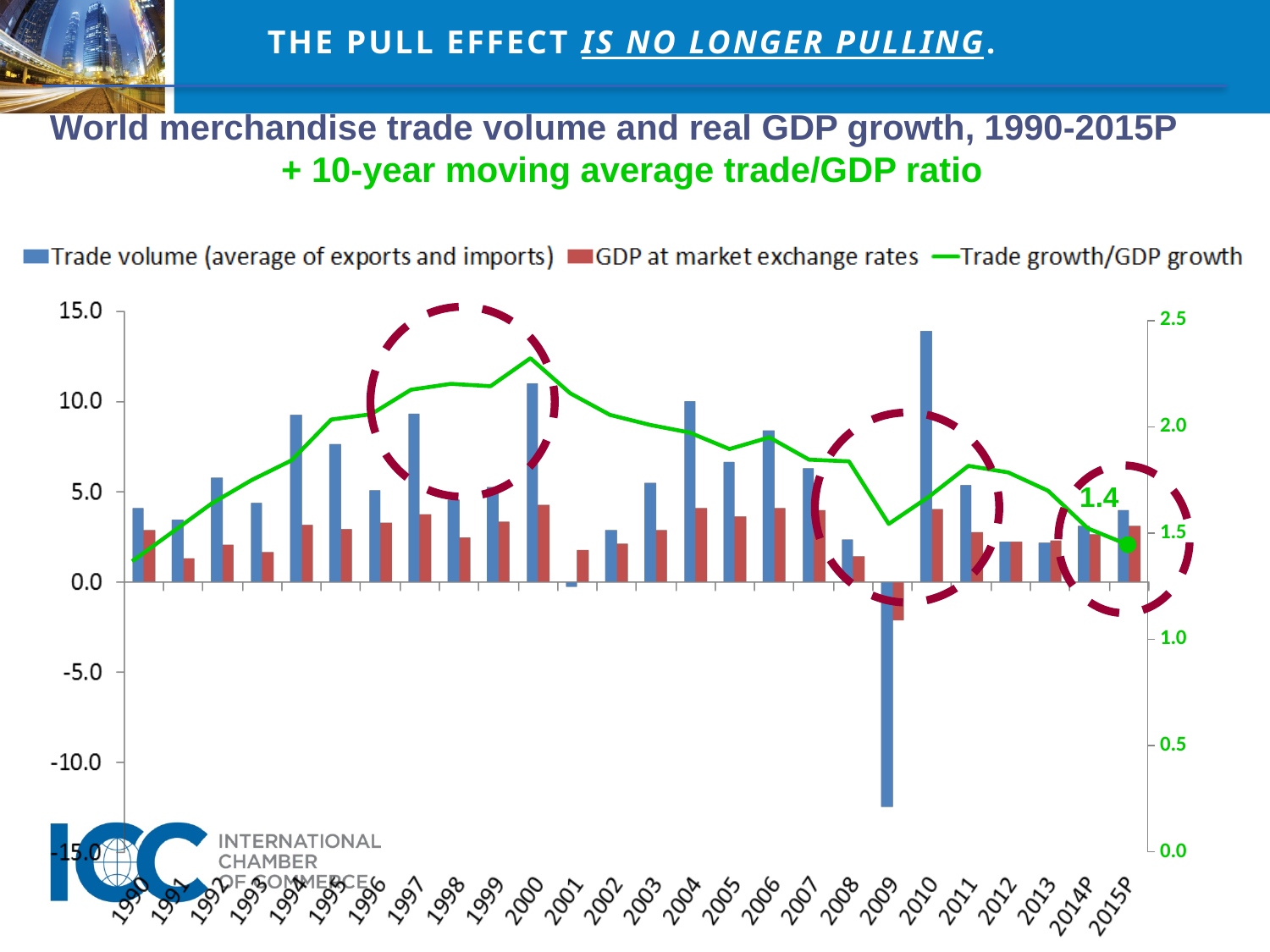
How many years are shown on the x axis? 26 Does the Trade growth/GDP growth line generally rise or fall from 2000 to 2015P? fall What is the value of the Trade growth/GDP growth line for 2015P? 1.4 How many series does the legend list? 3 Is the Trade volume value for 2010 greater or less than 10.0? greater In which year is the Trade volume bar highest? 2010 Is the GDP at market exchange rates value for 2004 greater or less than 5.0? less Is the Trade volume value for 2009 greater or less than -10.0? less What kind of chart is this? Combined bar and line chart In which year is the Trade volume bar lowest? 2009 Which is larger in 2010: the Trade volume bar or the GDP at market exchange rates bar? Trade volume Which year has the larger Trade volume bar, 1994 or 2001? 1994